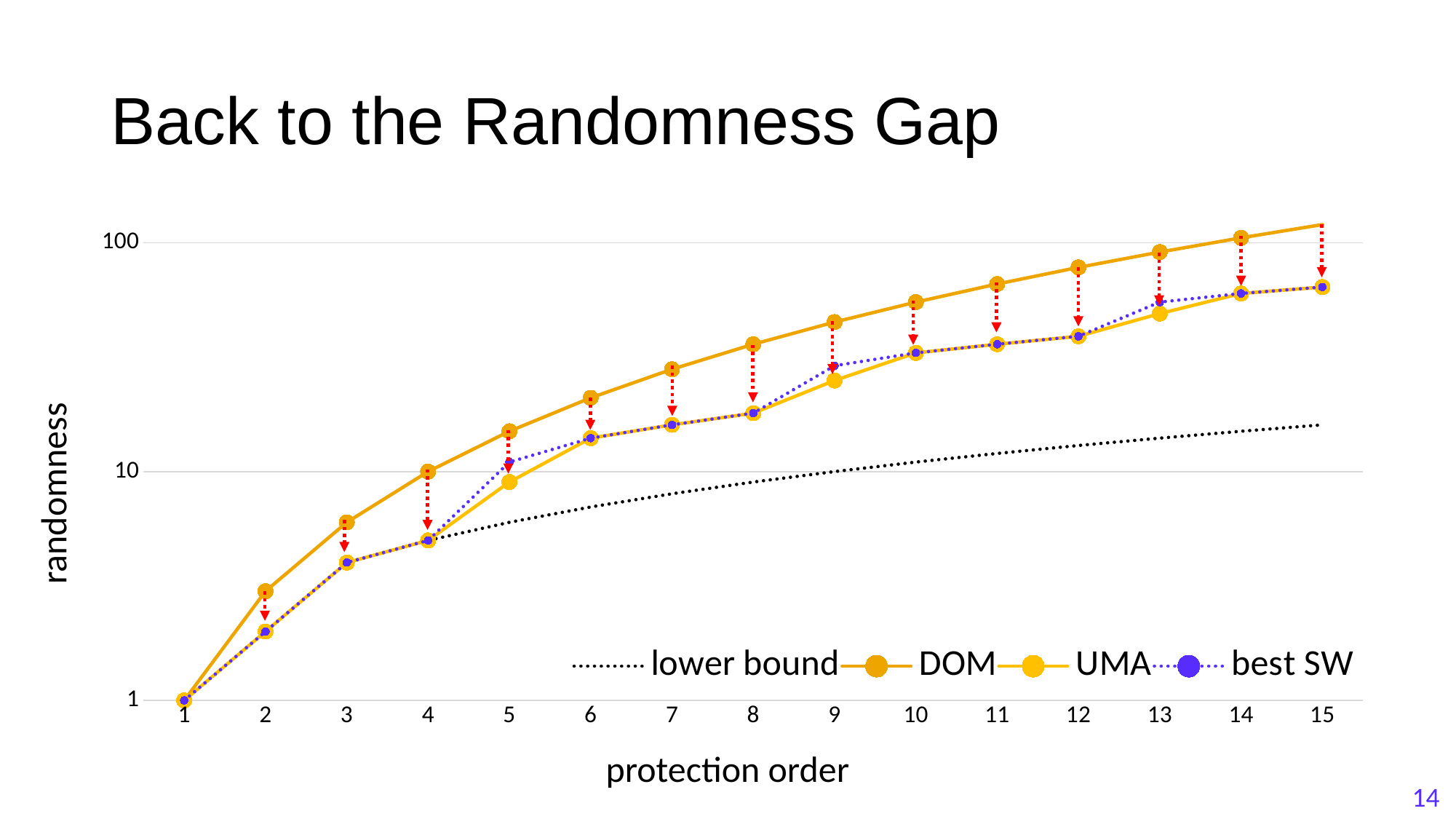
What is the randomness value for DOM at protection order 1? 1 At protection order 9, which is larger, DOM or UMA? DOM What is the randomness value for DOM at protection order 4? 10 What is the label of the x axis? protection order Is the lower bound value at protection order 15 greater or less than 100? less How many series does the legend list? 4 How many protection order values are shown on the x axis? 15 Is the best SW value at protection order 10 greater or less than 10? greater Is the DOM value at protection order 15 greater or less than 100? greater Do the randomness values rise or fall as protection order increases? rise What kind of chart is shown on the slide? line chart